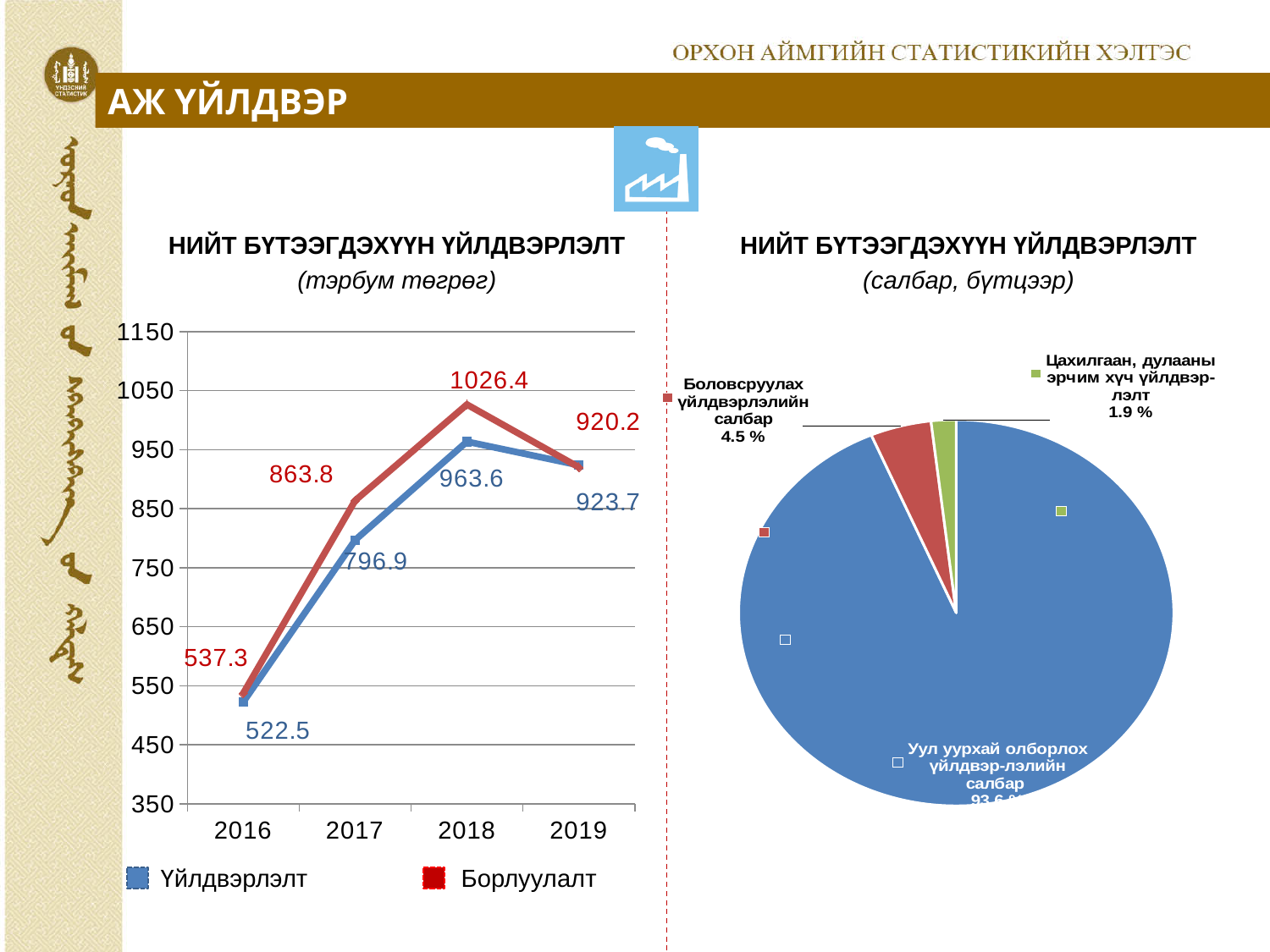
On the left line chart, does Үйлдвэрлэлт rise or fall from 2016 to 2018? rise On the left line chart, in which year is Борлуулалт highest? 2018 What kind of chart is shown on the right side of the slide? pie chart On the right pie chart, what share does the Боловсруулах үйлдвэрлэлийн салбар slice have? 4.5 % On the left line chart, which is larger in 2019, Үйлдвэрлэлт or Борлуулалт? Үйлдвэрлэлт On the left line chart, what is the difference between Борлуулалт and Үйлдвэрлэлт in 2017? 66.9 On the left line chart, how many years are shown on the x axis? 4 On the left line chart, in which year is Үйлдвэрлэлт lowest? 2016 On the left line chart, what is the Борлуулалт value for 2016? 537.3 On the left line chart, what is the Үйлдвэрлэлт value for 2018? 963.6 On the left line chart, how many series does the legend list? 2 On the left line chart, what is the Борлуулалт value for 2019? 920.2